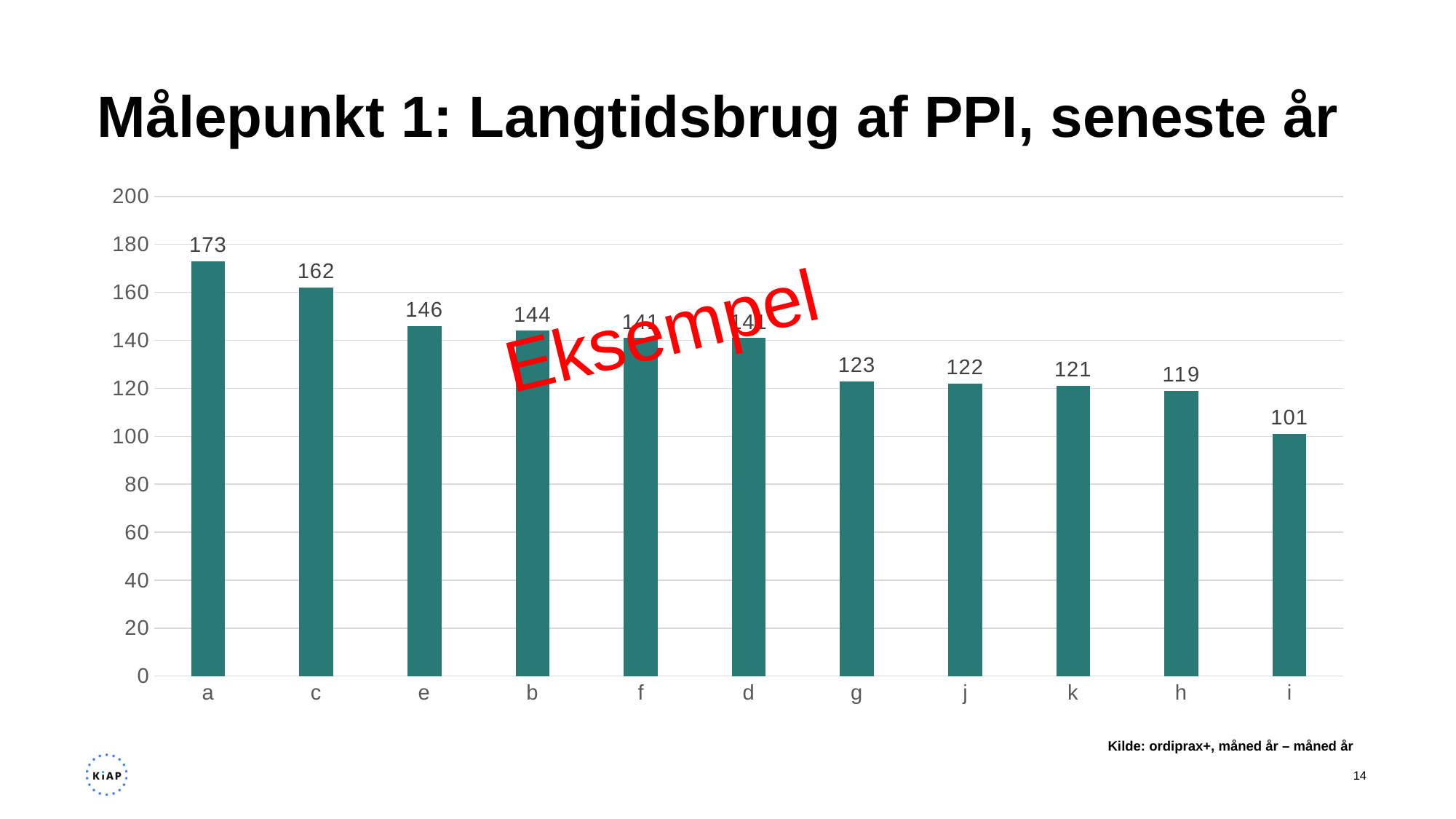
Is the value for f greater or less than 120? greater What kind of chart is shown on the slide? bar chart What is the value for category c? 162 What is the value for category i? 101 What is the difference between the values for e and i? 45 What is the difference between the values for a and c? 11 Which category has the highest value? a Which is larger, the value for b or the value for h? b What is the value for category a? 173 How many categories are shown on the x axis? 11 Which category has the lowest value? i What is the value for category g? 123